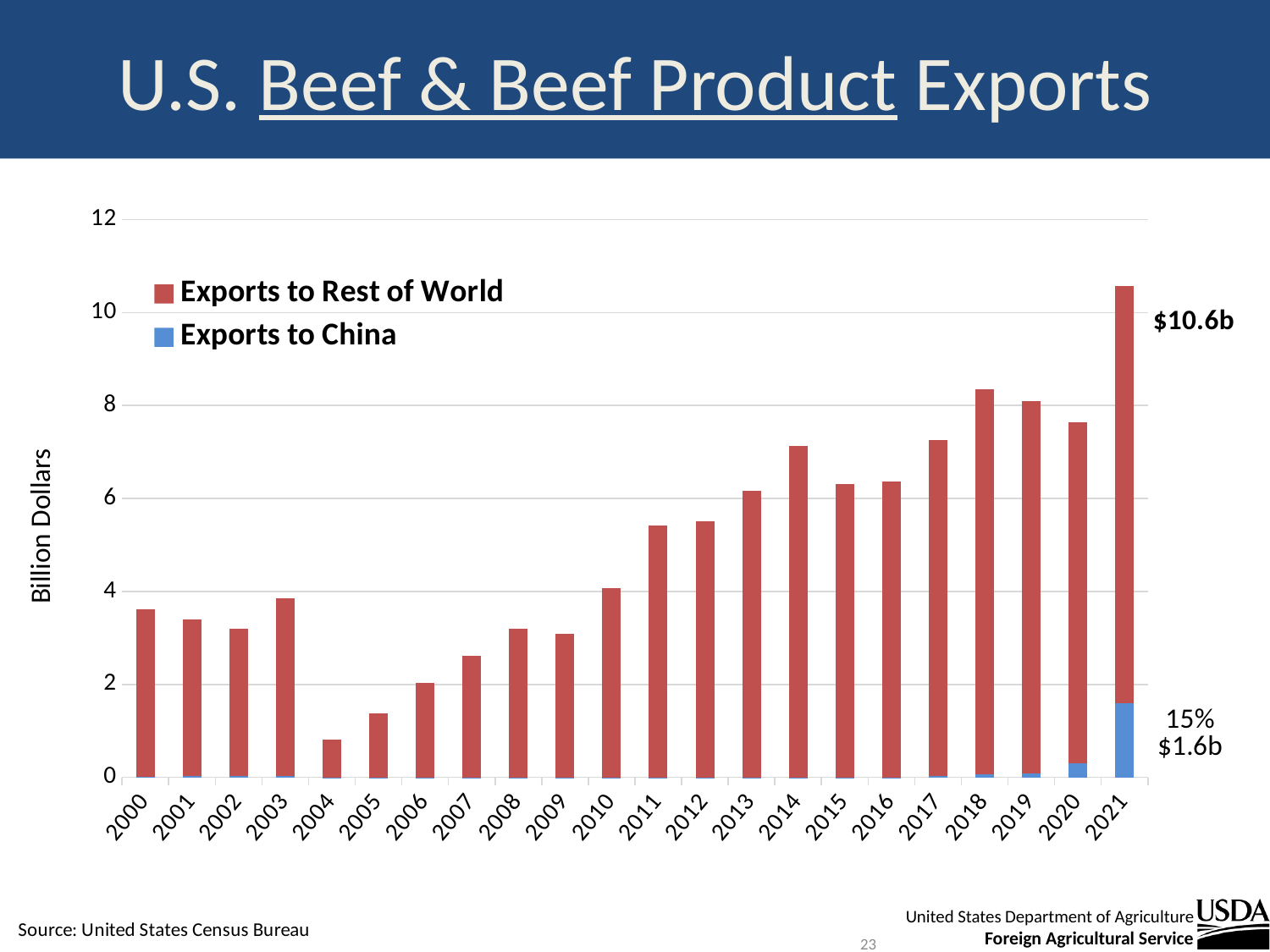
Is the total value for 2018 greater or less than 8? greater Do total exports rise or fall from 2004 to 2008? rise How many series does the legend list? 2 What kind of chart is shown on the slide? bar chart How many years are shown on the x axis? 22 What is the total value of U.S. beef and beef product exports in 2021? $10.6b What share of 2021 exports went to China? 15% Which year has the lowest total exports? 2004 Which year has larger total exports, 2013 or 2014? 2014 Which year has the highest total exports? 2021 What is the value of exports to China in 2021? $1.6b Is the total value for 2011 greater or less than 6? less